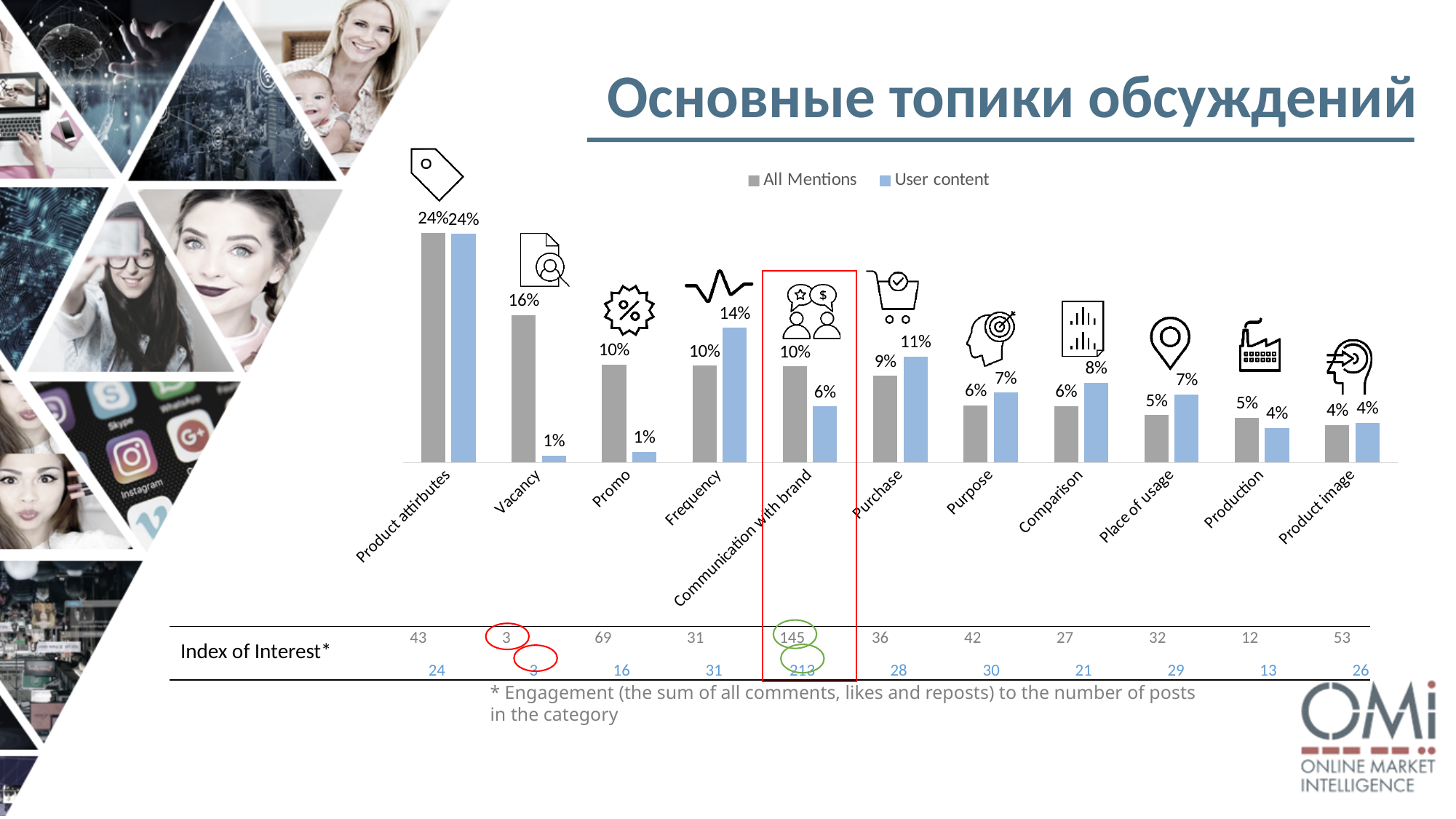
What is the User content value for Communication with brand? 6% What is the difference between the All Mentions and User content values for Vacancy? 15% Which category has the lowest All Mentions value? Product image Which series is shown in blue in the legend? User content Which category has the highest All Mentions value? Product attributes What type of chart is shown on the slide? Bar chart What is the difference between the User content values for Frequency and Promo? 13% How many series does the legend list? 2 How many categories are shown on the x axis of the chart? 11 For Purchase, which is larger: All Mentions or User content? User content What is the All Mentions value for Vacancy? 16% What is the User content value for Frequency? 14%